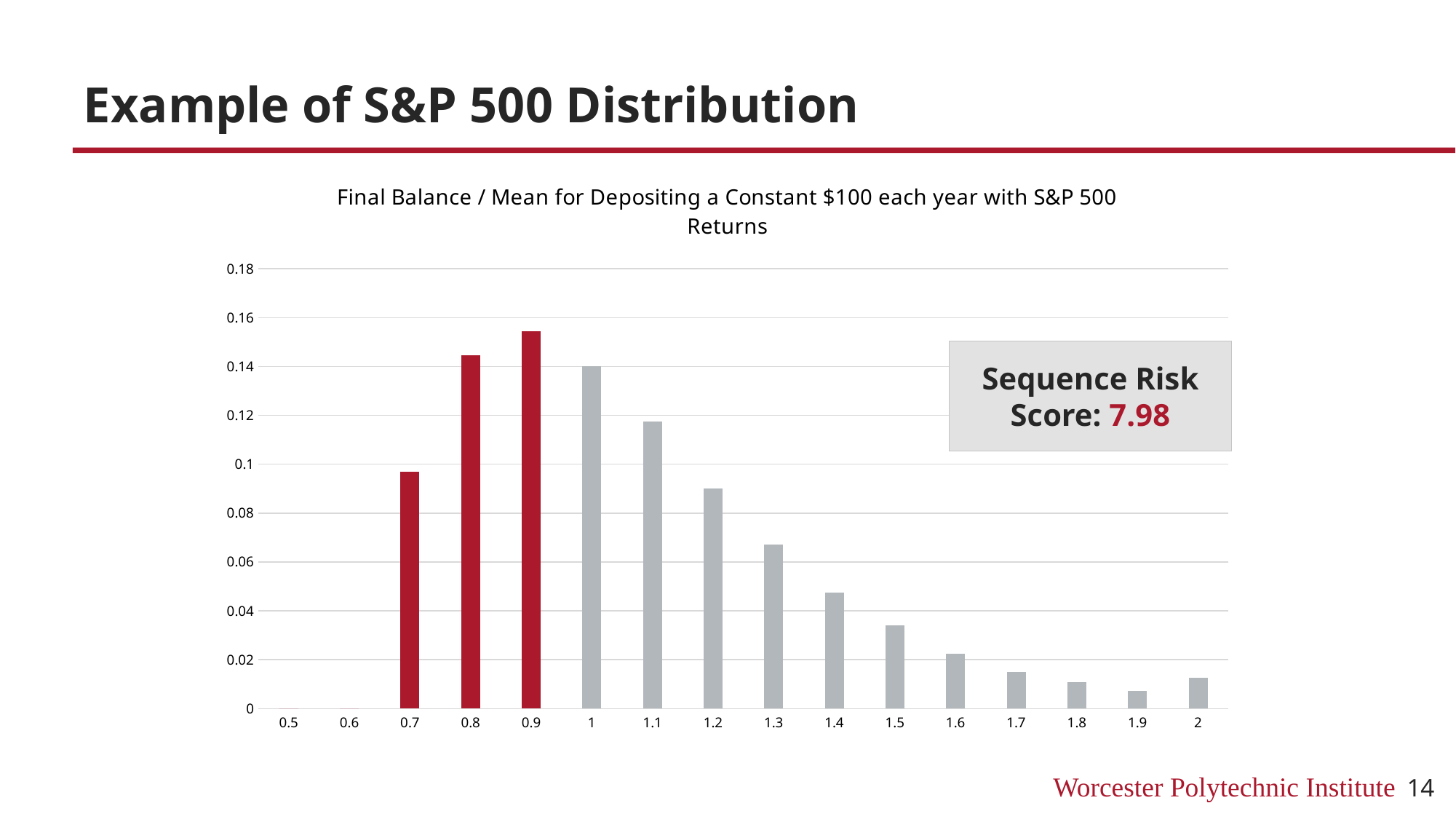
Which has the larger value, 1.2 or 1.3? 1.2 How many categories are labelled on the x axis of the chart? 16 Is the value for 1.5 greater or less than 0.04? less Which x-axis categories are shown with red bars? 0.7, 0.8 and 0.9 Which x-axis categories have no visible bar? 0.5 and 0.6 What is the title of the chart? Final Balance / Mean for Depositing a Constant $100 each year with S&P 500 Returns Is the value for 1.1 greater or less than 0.1? greater Is the value for 1.2 greater or less than 0.1? less Do the bar values rise or fall along the x axis from 0.9 to 1.9? fall Which x-axis category has the tallest bar? 0.9 What kind of chart is shown on the slide? bar chart